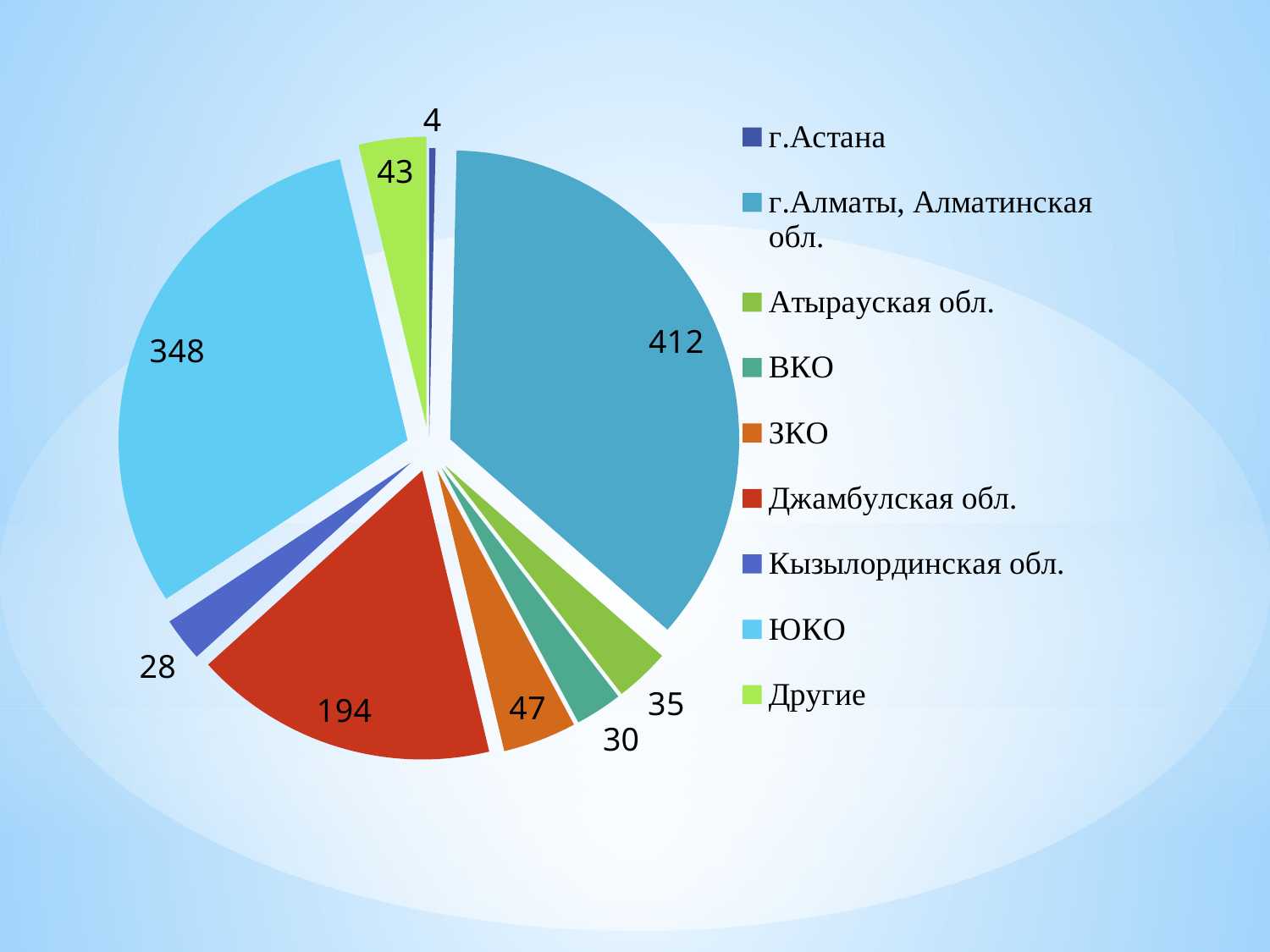
How many categories does the pie chart show? 9 Which is larger, the value for Атырауская обл. or the value for ВКО? Атырауская обл. What value is shown for ЗКО in the pie chart? 47 What value is shown for г.Алматы, Алматинская обл. in the pie chart? 412 Which category has the smallest slice in the pie chart? г.Астана What is the difference between the values for г.Алматы, Алматинская обл. and ЮКО? 64 What type of chart is shown on the slide? Pie chart Which category has the largest slice in the pie chart? г.Алматы, Алматинская обл. What value is shown for ЮКО in the pie chart? 348 What value is shown for Джамбулская обл. in the pie chart? 194 What value is shown for г.Астана in the pie chart? 4 What is the total of all the values shown in the pie chart? 1141